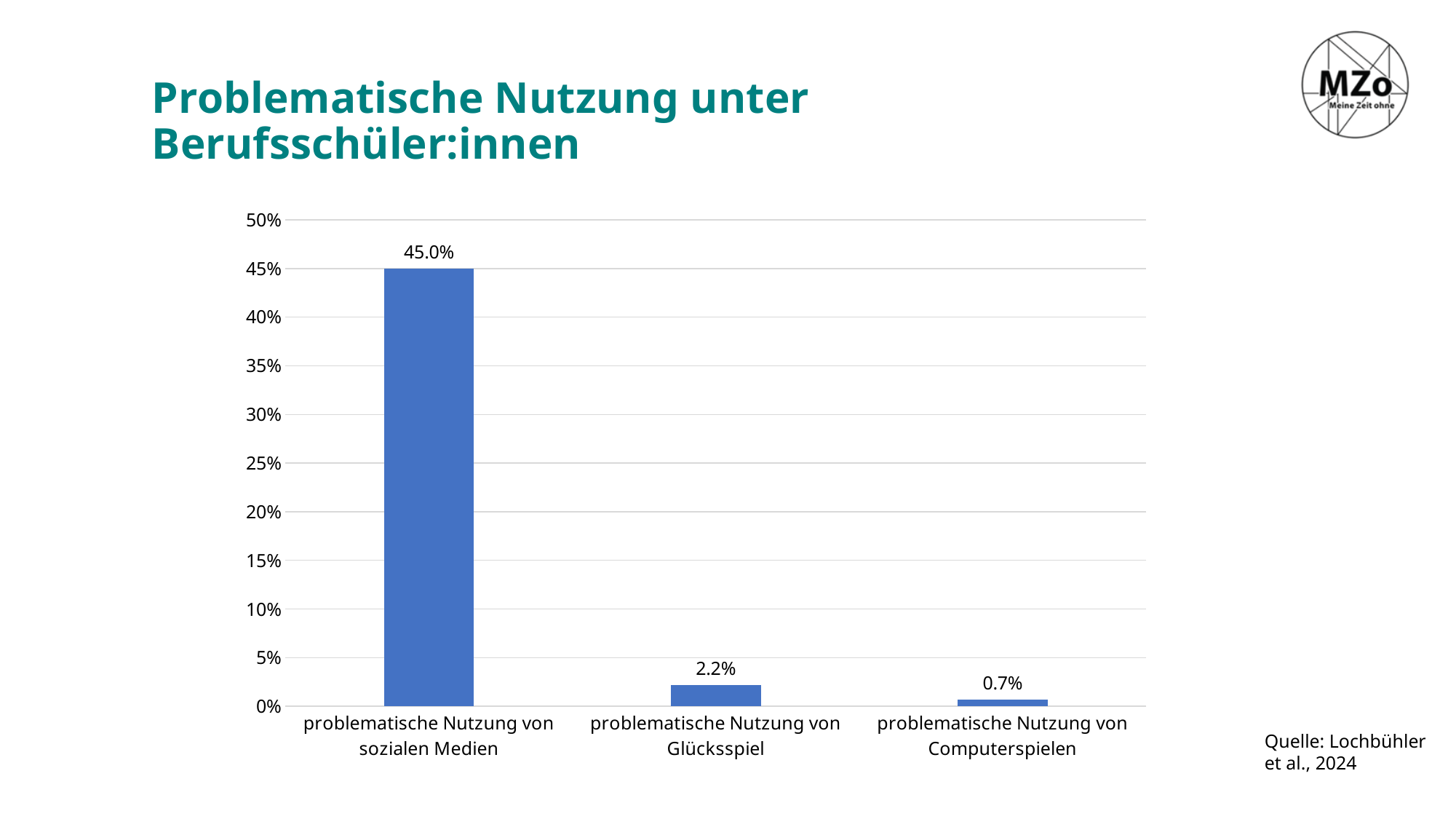
What is the value for problematische Nutzung von sozialen Medien? 45.0% What is the title of the slide? Problematische Nutzung unter Berufsschüler:innen What is the difference between the values for problematische Nutzung von sozialen Medien and problematische Nutzung von Glücksspiel? 42.8% What is the value for problematische Nutzung von Glücksspiel? 2.2% Which is larger: the value for problematische Nutzung von Glücksspiel or for problematische Nutzung von Computerspielen? problematische Nutzung von Glücksspiel Which category has the lowest value? problematische Nutzung von Computerspielen What is the value for problematische Nutzung von Computerspielen? 0.7% How many categories are shown in the chart? 3 Is the value for problematische Nutzung von sozialen Medien greater or less than 40%? greater Which category has the highest value? problematische Nutzung von sozialen Medien What kind of chart is shown on the slide? bar chart What is the difference between the values for problematische Nutzung von Glücksspiel and problematische Nutzung von Computerspielen? 1.5%